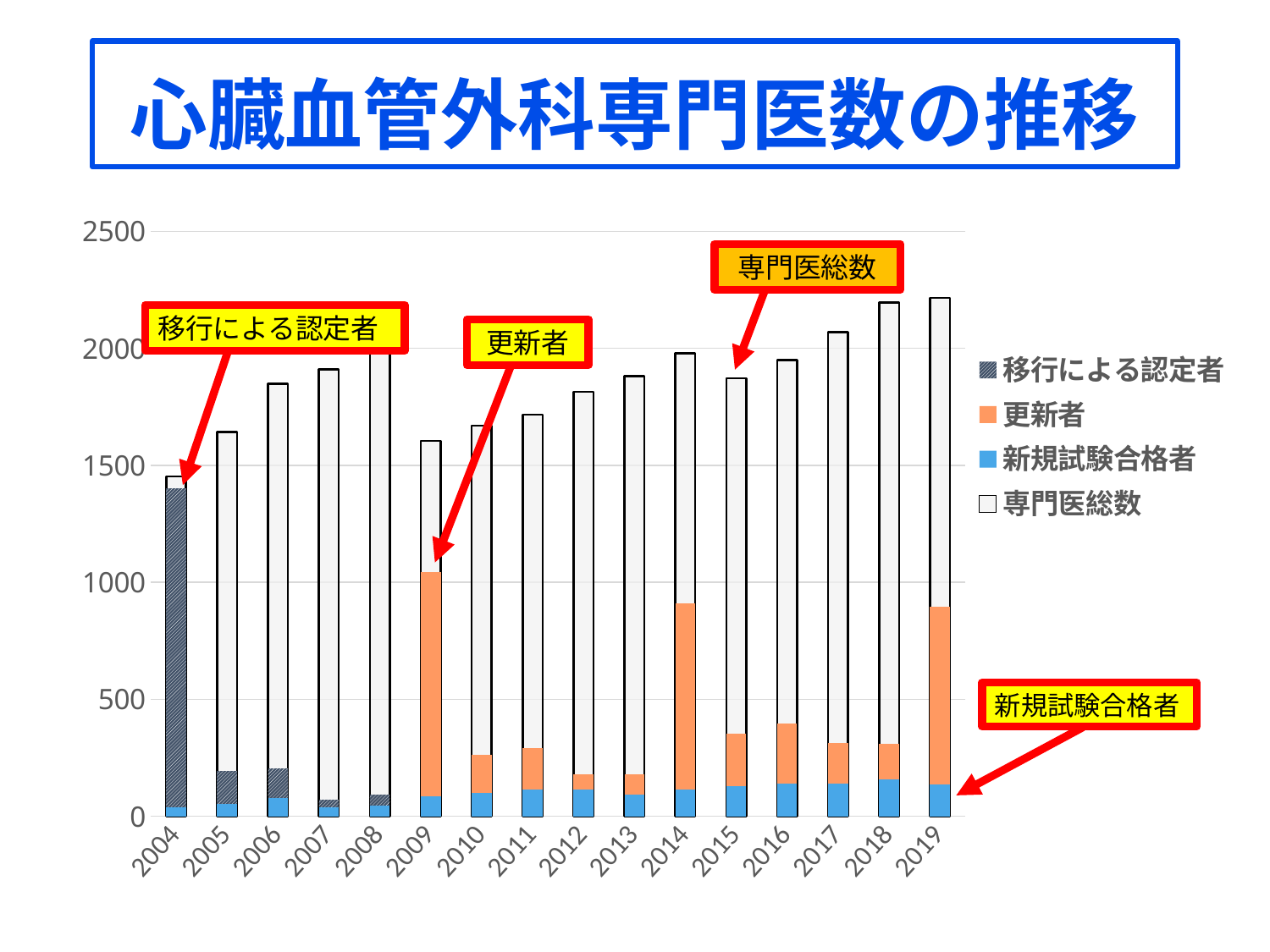
Is the 更新者 value for 2014 greater or less than 1000? less Which is larger, the 専門医総数 for 2004 or for 2009? 2009 Which year has the lowest 専門医総数 bar? 2004 How many series does the chart's legend list? 4 Which legend entry is shown with an orange colour? 更新者 How many years are shown on the x axis of the chart? 16 Is the 移行による認定者 value for 2004 greater or less than 1000? greater Is the 専門医総数 value for 2019 greater or less than 2000? greater What is the title of the slide containing the chart? 心臓血管外科専門医数の推移 Do the 専門医総数 bars rise or fall from 2009 to 2014? rise What kind of chart is shown on the slide? stacked bar chart